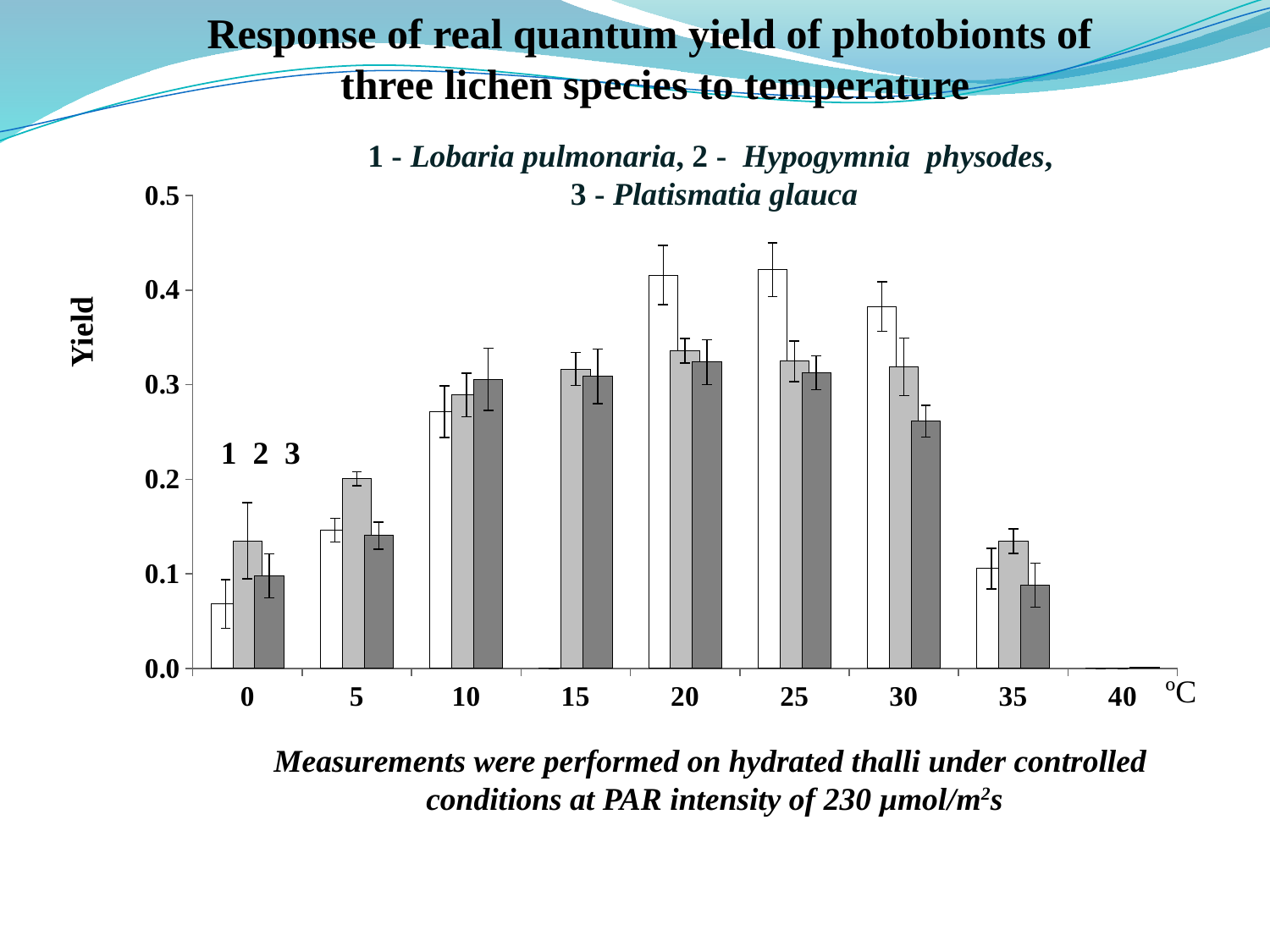
What is the label of the y axis? Yield At 30 °C, which has the larger yield: Lobaria pulmonaria (series 1) or Platismatia glauca (series 3)? Lobaria pulmonaria (series 1) How many lichen species (series) are plotted in the chart? 3 At which temperature is the yield lowest for all three species? 40 °C What kind of chart is shown on the slide? bar chart At 0 °C, which has the larger yield: Lobaria pulmonaria (series 1) or Hypogymnia physodes (series 2)? Hypogymnia physodes (series 2) How many temperature categories are shown on the x axis? 9 Is the yield for Lobaria pulmonaria (series 1) at 20 °C greater or less than 0.4? greater Is the yield for Platismatia glauca (series 3) at 30 °C greater or less than 0.3? less Is the yield for Platismatia glauca (series 3) at 35 °C greater or less than 0.1? less Which species is labelled 3 in the chart legend? Platismatia glauca